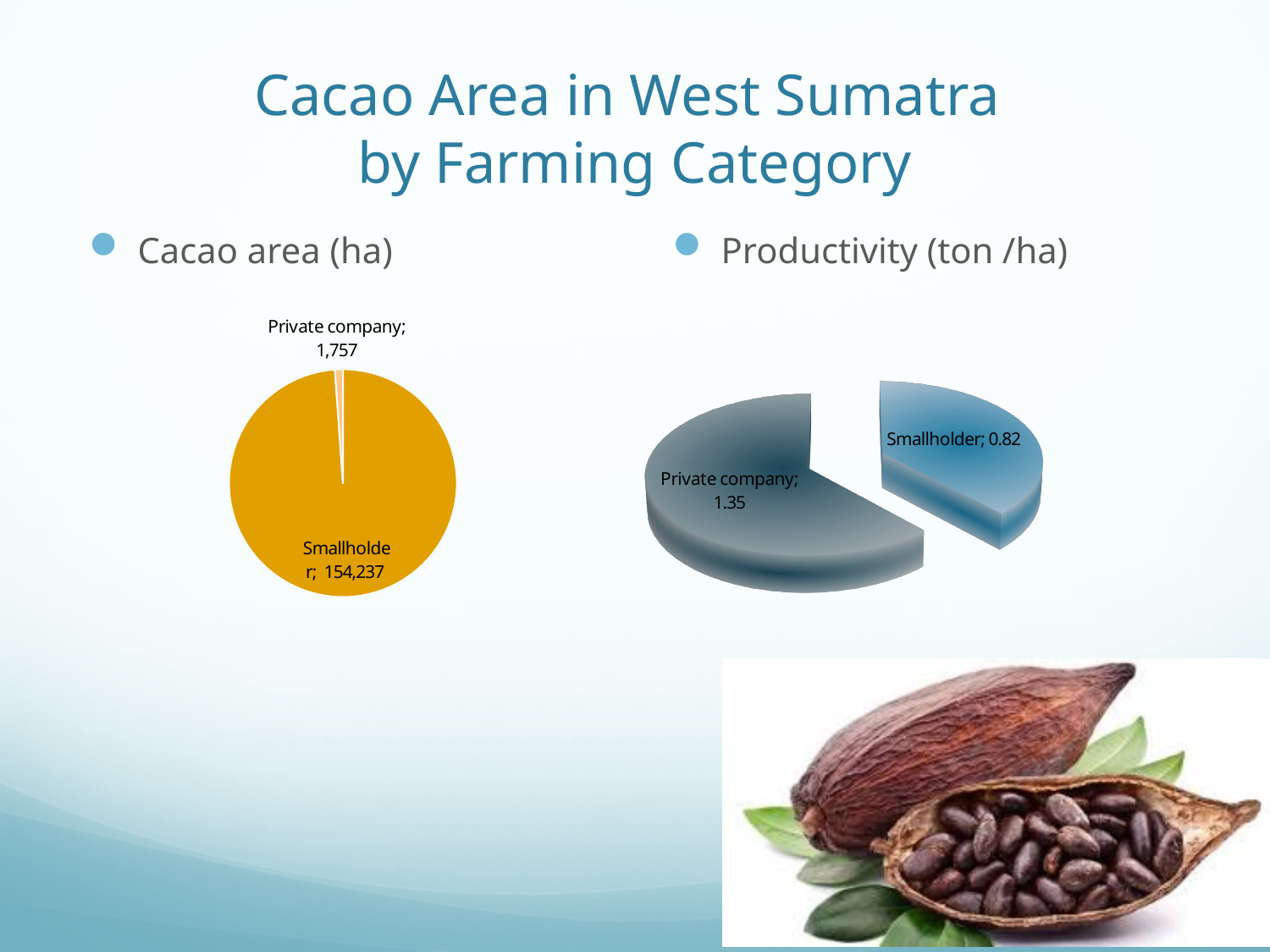
What is the title of the slide containing the two charts? Cacao Area in West Sumatra by Farming Category In the Cacao area (ha) chart, which category has the largest slice? Smallholder In the Productivity (ton /ha) chart, which is larger, Private company or Smallholder? Private company In the Productivity (ton /ha) chart, which category has the smallest value? Smallholder In the Cacao area (ha) chart, what is the value for Private company? 1,757 In the Productivity (ton /ha) chart, how much higher is Private company than Smallholder? 0.53 In the Productivity (ton /ha) chart, what is the value for Smallholder? 0.82 How many slices does the Cacao area (ha) pie chart have? 2 In the Productivity (ton /ha) chart, what is the value for Private company? 1.35 In the Cacao area (ha) chart, what is the value for Smallholder? 154,237 In the Cacao area (ha) chart, what is the difference between the Smallholder and Private company values? 152,480 What kind of chart is the Productivity (ton /ha) chart? Pie chart